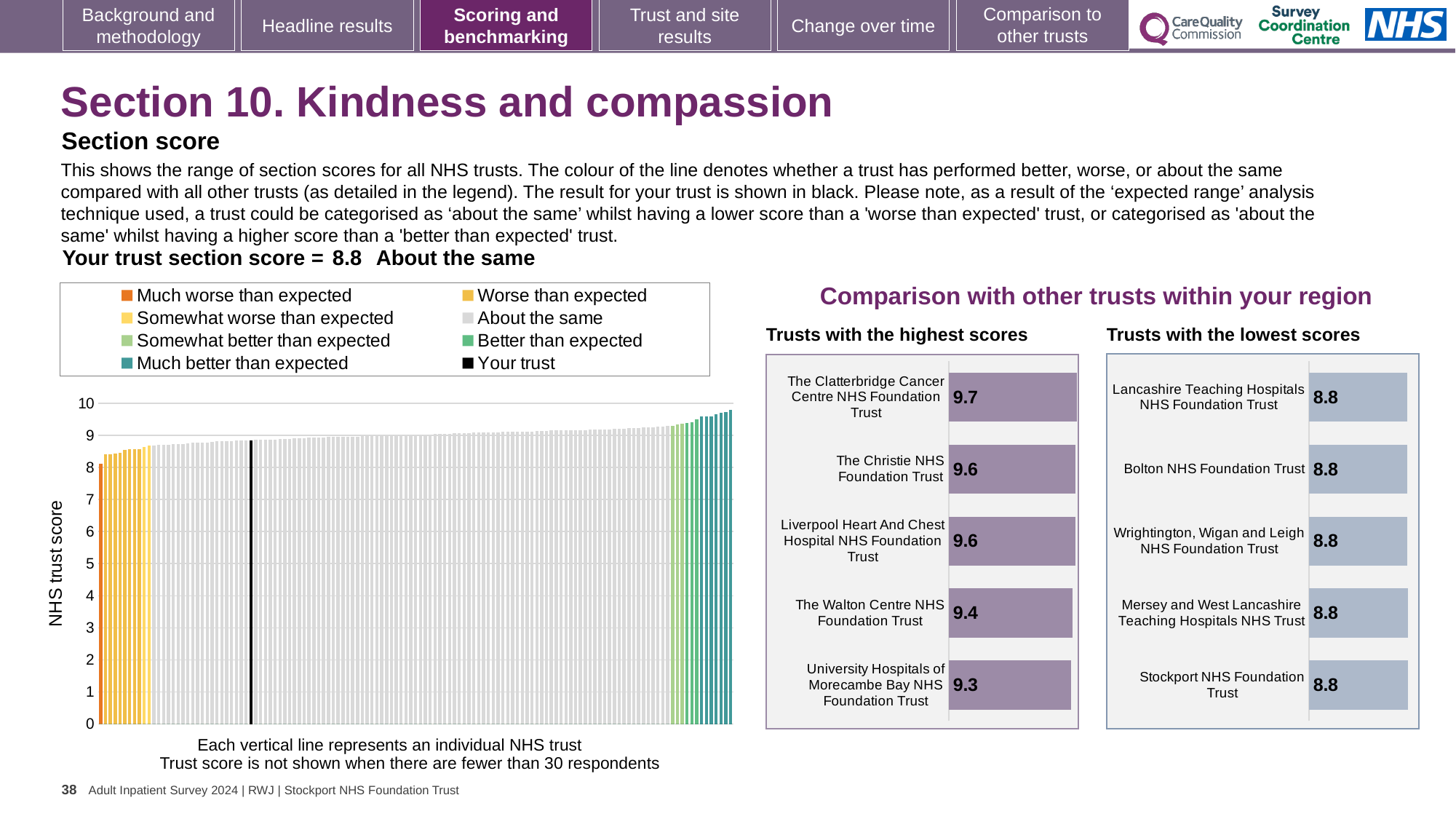
In the 'Trusts with the highest scores' chart, what is the score for The Walton Centre NHS Foundation Trust? 9.4 In the large chart on the left showing NHS trust scores, how many entries does the legend list? 8 In the 'Trusts with the lowest scores' chart, what is the score for Stockport NHS Foundation Trust? 8.8 In the 'Trusts with the highest scores' chart, what is the score for The Clatterbridge Cancer Centre NHS Foundation Trust? 9.7 In the 'Trusts with the lowest scores' chart, what is the score for Bolton NHS Foundation Trust? 8.8 In the 'Trusts with the highest scores' chart, which has the larger score: The Walton Centre NHS Foundation Trust or University Hospitals of Morecambe Bay NHS Foundation Trust? The Walton Centre NHS Foundation Trust In the 'Trusts with the highest scores' chart, what is the difference between the scores of The Clatterbridge Cancer Centre NHS Foundation Trust and University Hospitals of Morecambe Bay NHS Foundation Trust? 0.4 How many trusts are shown in the 'Trusts with the highest scores' chart? 5 In the 'Trusts with the highest scores' chart, which trust has the lowest score? University Hospitals of Morecambe Bay NHS Foundation Trust In the large chart on the left showing NHS trust scores, what kind of chart is it? Bar chart In the 'Trusts with the highest scores' chart, which trust has the highest score? The Clatterbridge Cancer Centre NHS Foundation Trust How many trusts are shown in the 'Trusts with the lowest scores' chart? 5